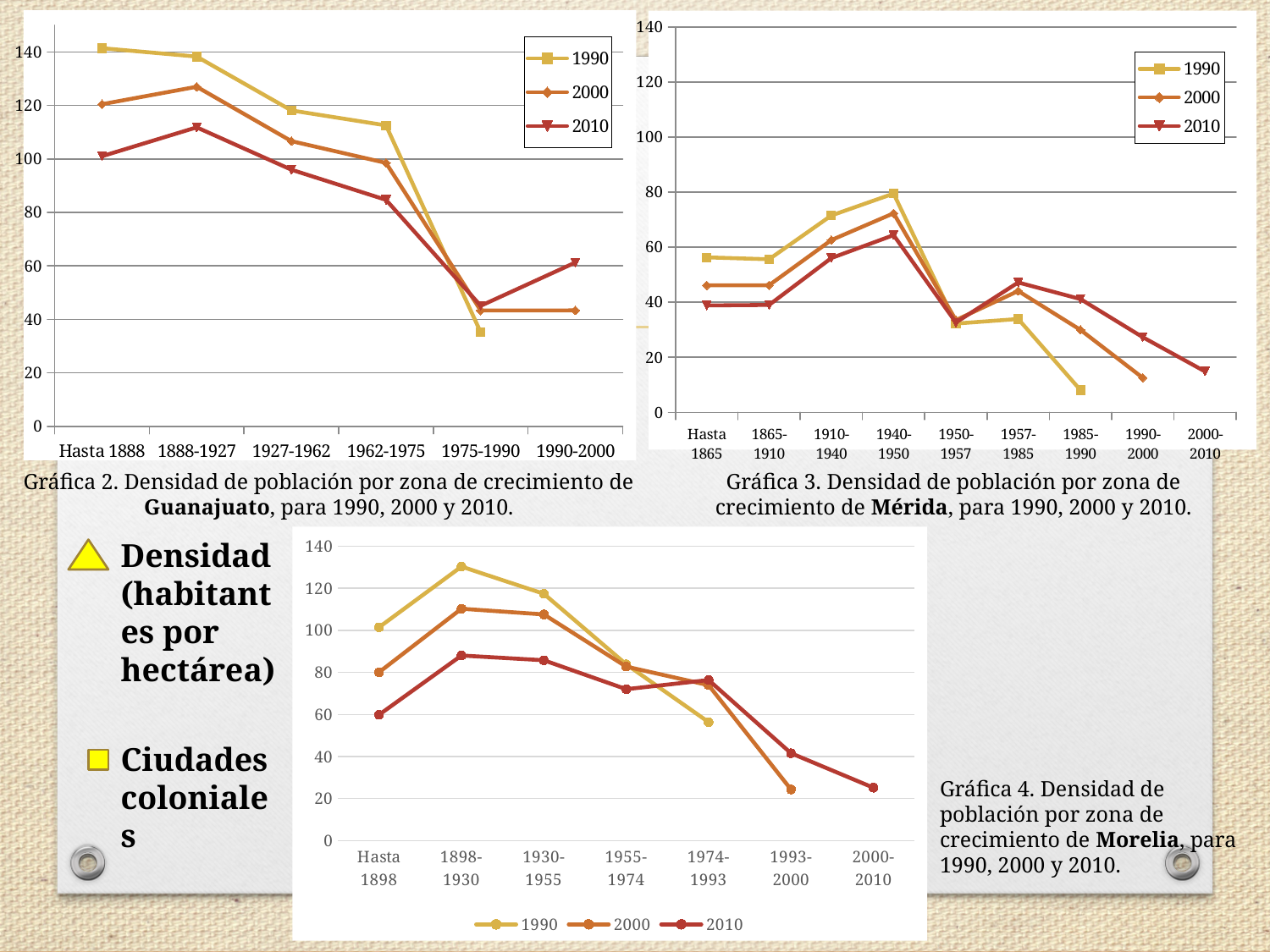
What kind of chart is Gráfica 2 (Guanajuato)? line chart In Gráfica 2 (Guanajuato), is the 1990 value for '1975-1990' greater or less than 40? less In Gráfica 3 (Mérida), is the 1990 value for '1985-1990' greater or less than 20? less How many series does the legend of Gráfica 2 (Guanajuato) list? 3 In Gráfica 4 (Morelia), is the 2000 value for '1993-2000' greater or less than 40? less How many growth-zone categories are shown on the x axis of Gráfica 3 (Mérida)? 9 In Gráfica 2 (Guanajuato), which series has the highest value for 'Hasta 1888'? 1990 In Gráfica 4 (Morelia), at which category does the 1990 series reach its highest value? 1898-1930 In Gráfica 2 (Guanajuato), does the 1990 series generally rise or fall from 'Hasta 1888' to '1975-1990'? fall In Gráfica 3 (Mérida), at which category does the 1990 series reach its highest value? 1940-1950 How many growth-zone categories are shown on the x axis of Gráfica 2 (Guanajuato)? 6 In Gráfica 3 (Mérida), which is larger for '1985-1990': the 1990 value or the 2010 value? 2010